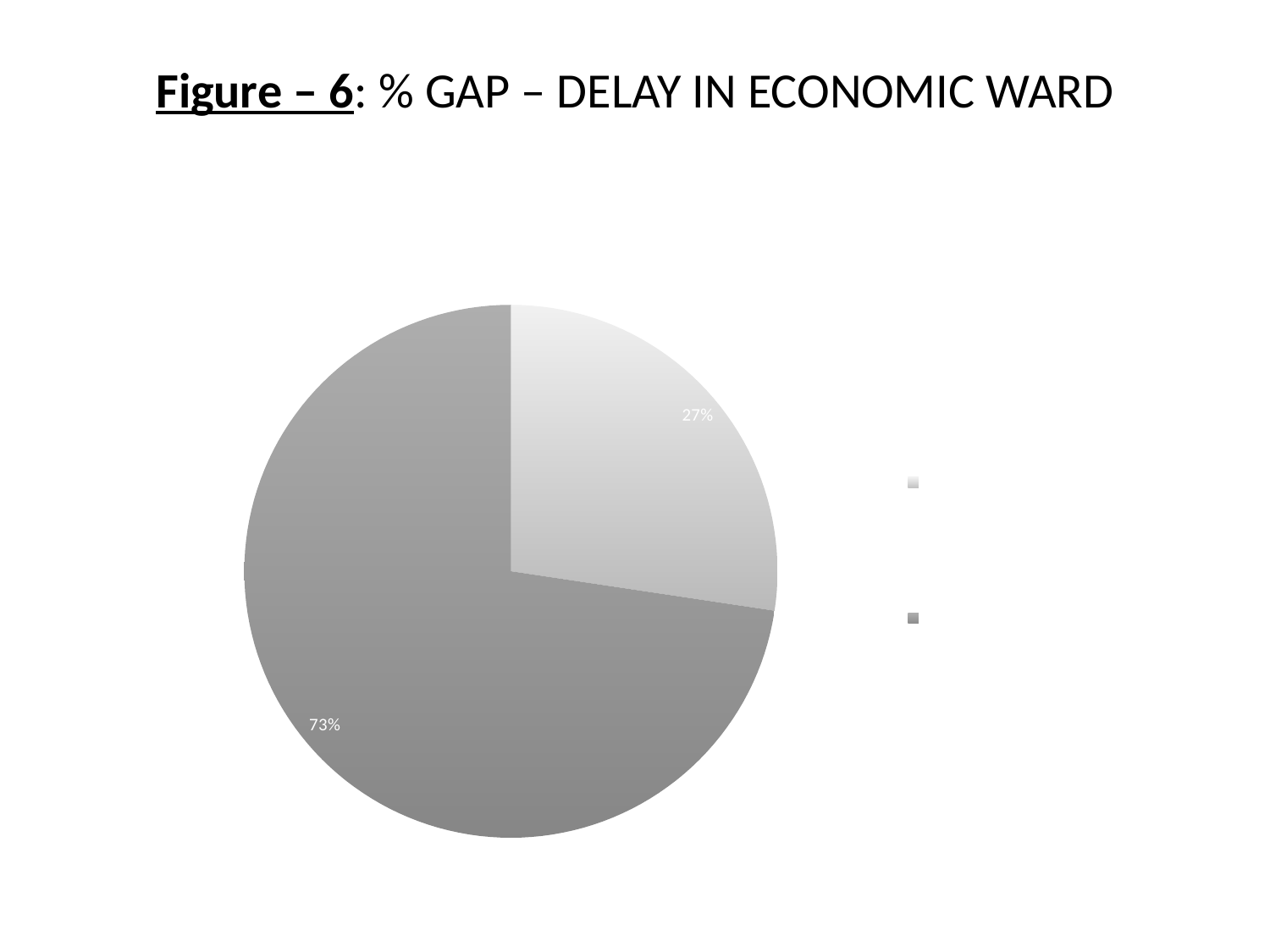
How many entries does the legend of the pie chart show? 2 Is the share of the lighter slice of the pie chart greater or less than 50%? less Which slice of the pie chart is the smallest, the lighter one or the darker one? the lighter one What percentage is shown on the larger, darker slice of the pie chart? 73% What percentage is shown on the smaller, lighter slice of the pie chart? 27% What kind of chart is shown on the slide? pie chart How many slices does the pie chart have? 2 What is the title of the chart on the slide? Figure – 6: % GAP – DELAY IN ECONOMIC WARD Is the darker slice of the pie chart larger or smaller than the lighter slice? larger Which slice of the pie chart is the largest, the lighter one or the darker one? the darker one What is the difference in percentage points between the two slices of the pie chart? 46